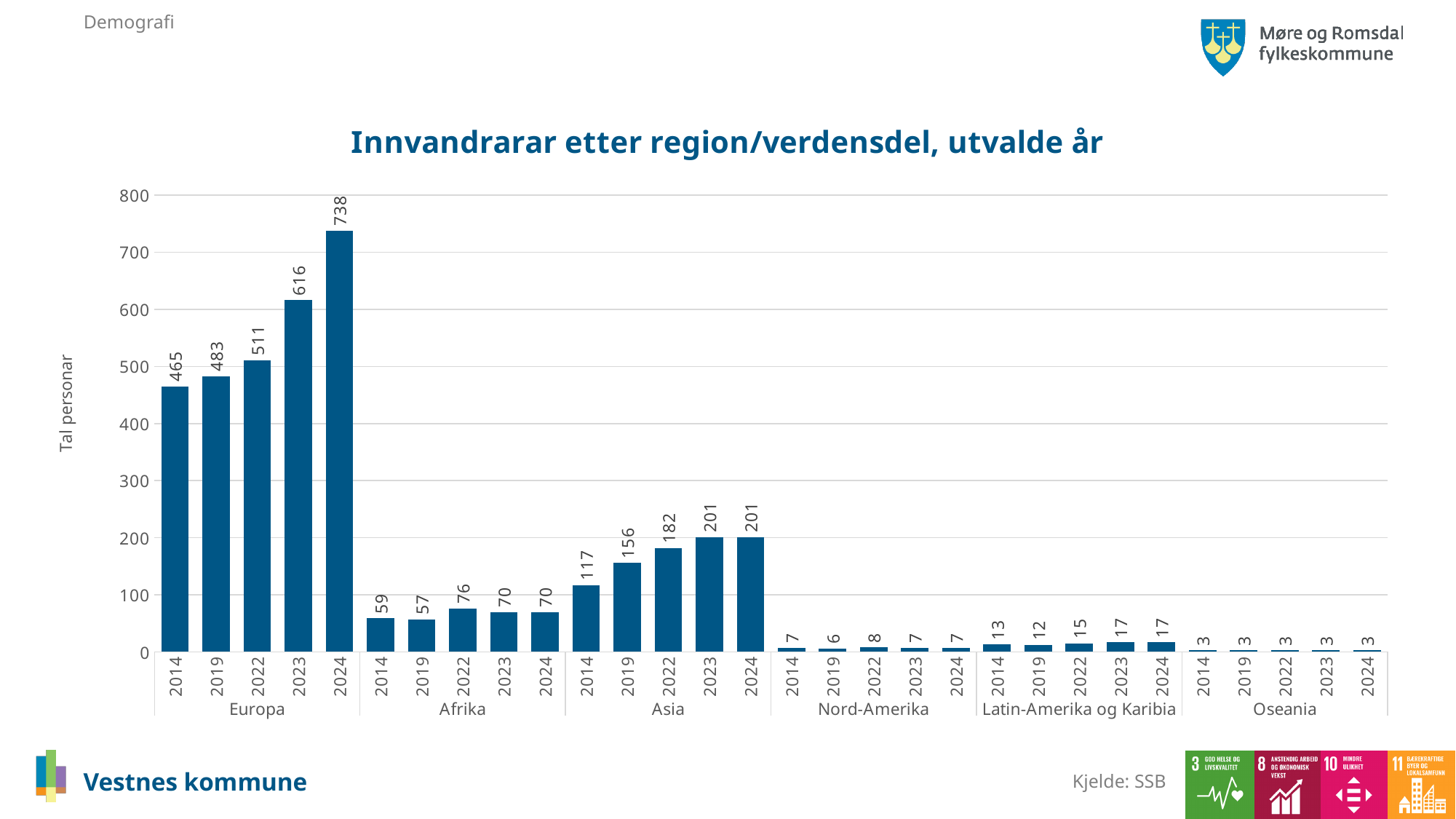
Which region has the lowest value in 2014? Oseania Is the value for Asia in 2022 greater or less than 100? greater What is the value for Latin-Amerika og Karibia in 2023? 17 What kind of chart is shown on the slide? Bar chart How many regions are shown on the x axis? 6 Do the values for Europa rise or fall from 2014 to 2024? Rise What is the value for Europa in 2024? 738 What is the value for Asia in 2019? 156 Which region has the highest value in 2024? Europa What is the difference between the Europa values for 2024 and 2014? 273 Which is larger, the value for Afrika in 2014 or the value for Afrika in 2019? Afrika in 2014 What is the value for Afrika in 2022? 76